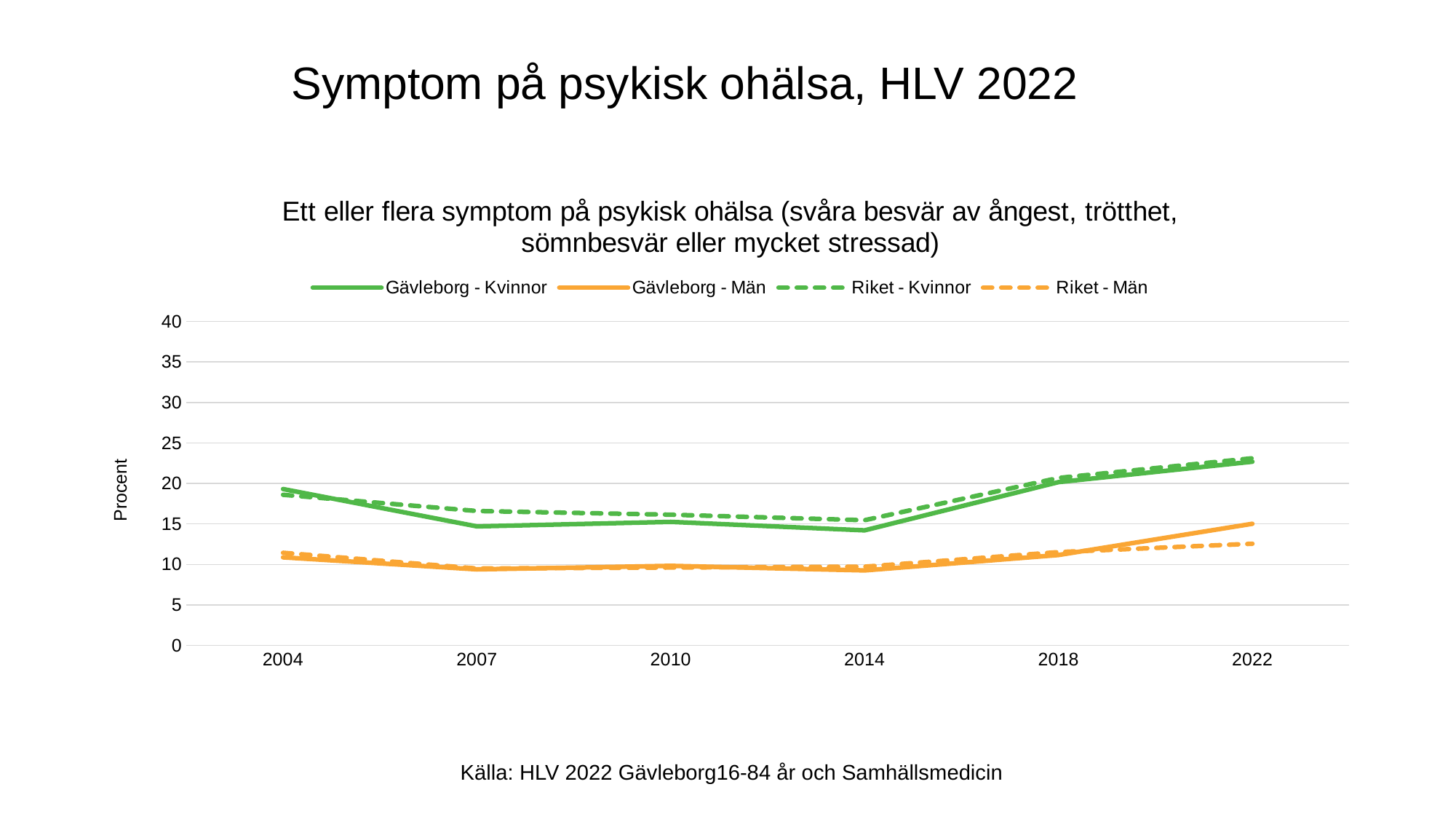
Is the value for Gävleborg - Kvinnor in 2014 greater or less than 20? less Does the Gävleborg - Män line rise or fall from 2014 to 2022? rise In which year is Gävleborg - Kvinnor at its highest? 2022 Is the value for Gävleborg - Män in 2022 greater or less than 10? greater In 2007, which is larger: Gävleborg - Kvinnor or Riket - Kvinnor? Riket - Kvinnor In 2022, which is larger: Gävleborg - Män or Riket - Män? Gävleborg - Män What kind of chart is shown on the slide? line chart How many years are shown on the x axis? 6 How many series does the legend list? 4 Which series has the lowest value in 2022? Riket - Män What is the label on the y axis? Procent Is the value for Gävleborg - Kvinnor in 2004 greater or less than 15? greater